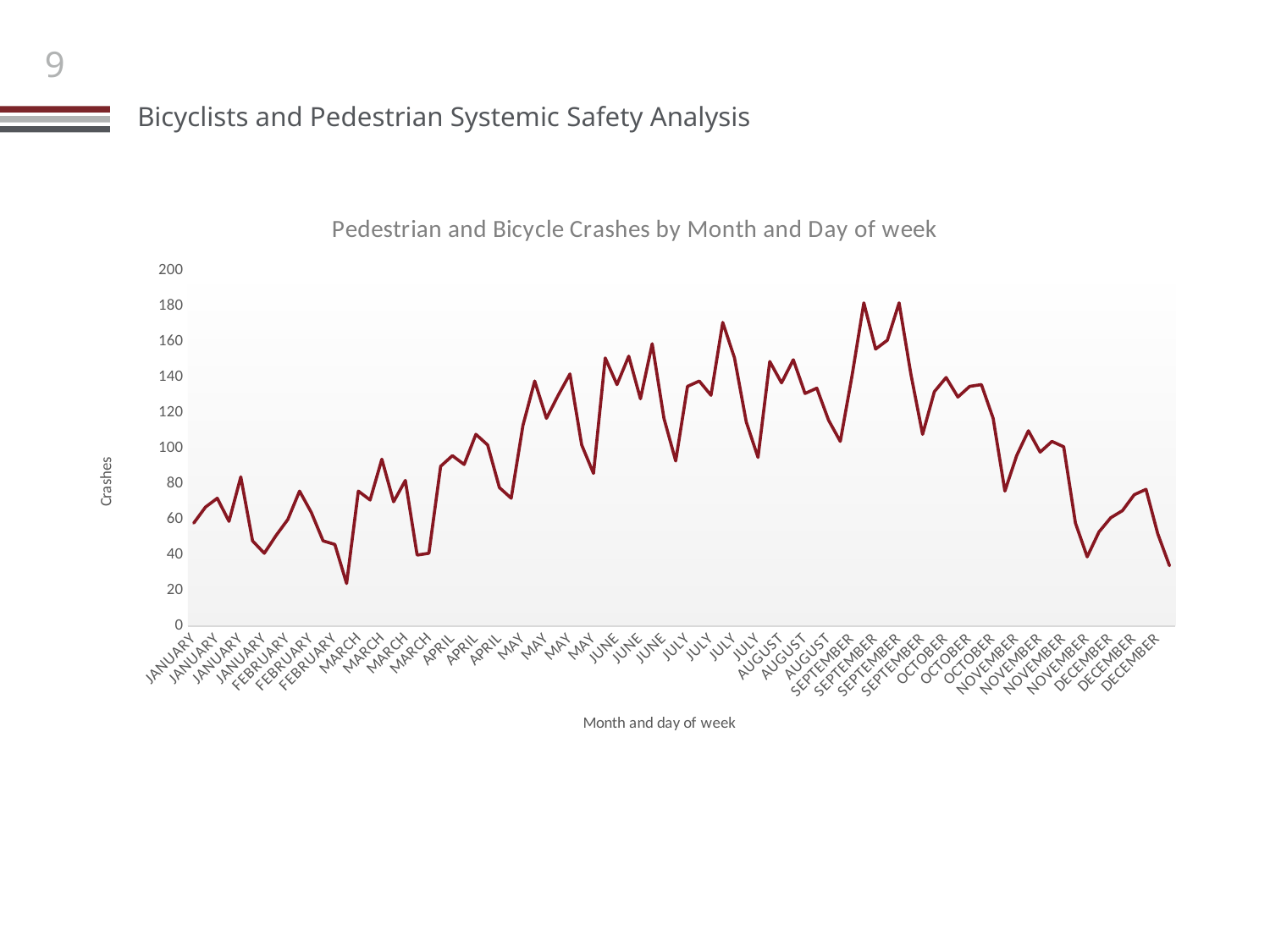
Is the highest point on the line greater or less than 160? greater What is the title of the chart? Pedestrian and Bicycle Crashes by Month and Day of week In which month does the line reach its highest value? September Do the values generally rise or fall from September to December? fall How many lines are plotted on the chart? 1 Is the lowest point on the line greater or less than 40? less What is the label on the vertical axis of the chart? Crashes Is the first (leftmost) point on the line greater or less than 80? less What kind of chart is shown on the slide? line chart Which is higher, the peak in September or the peak in July? September Do the values generally rise or fall from January to September? rise